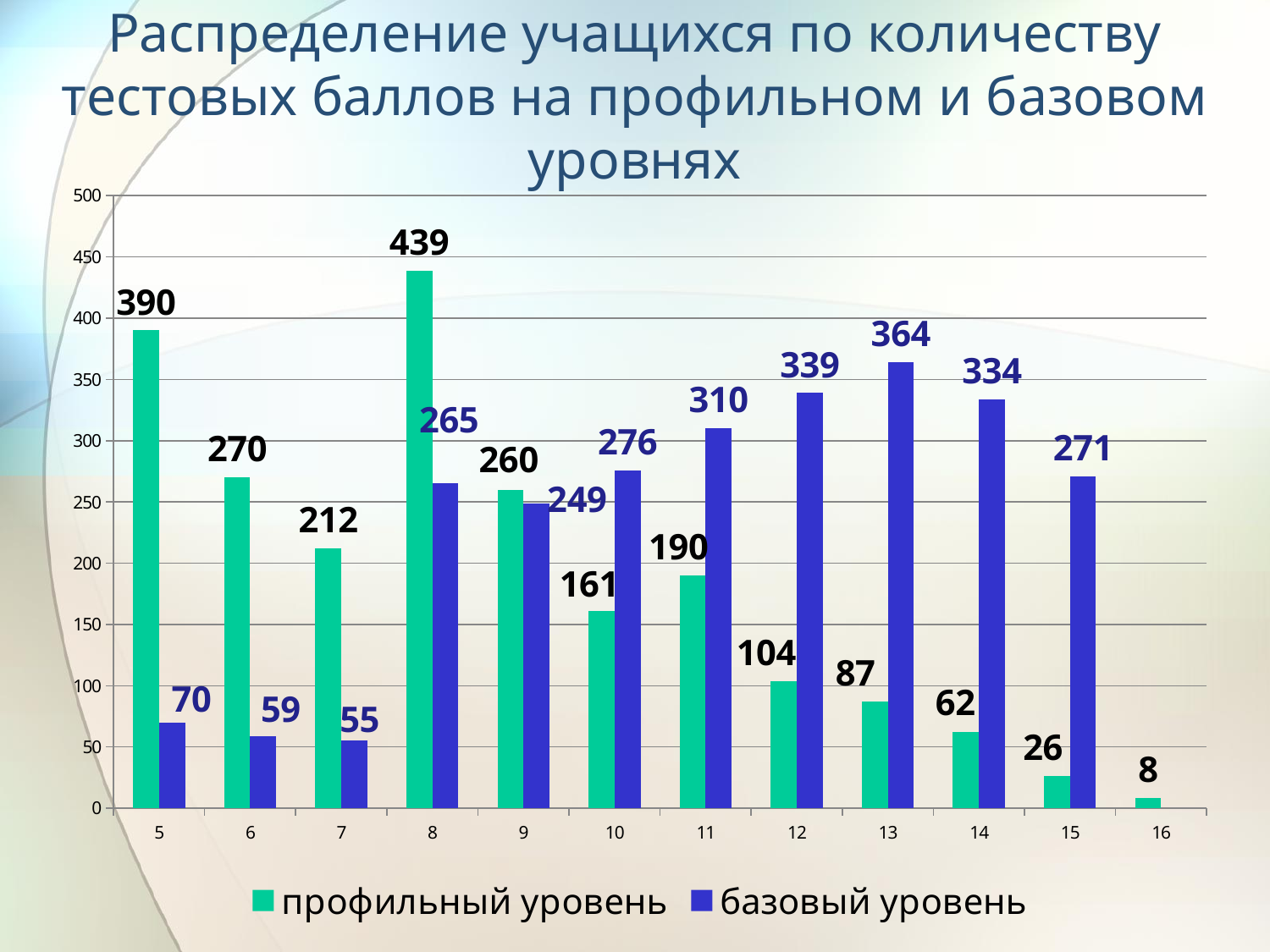
Which category has the lowest value for профильный уровень? 16 What is the value for профильный уровень at category 8? 439 What is the value for базовый уровень at category 13? 364 At category 12, which series has the larger value, профильный уровень or базовый уровень? базовый уровень What kind of chart is shown on the slide? bar chart What is the value for базовый уровень at category 5? 70 Which category has the highest value for базовый уровень? 13 What is the difference between профильный уровень and базовый уровень at category 5? 320 How many categories are shown on the x axis? 12 Does the value for профильный уровень rise or fall from category 12 to category 16? fall Which category has the highest value for профильный уровень? 8 How many series does the legend list? 2